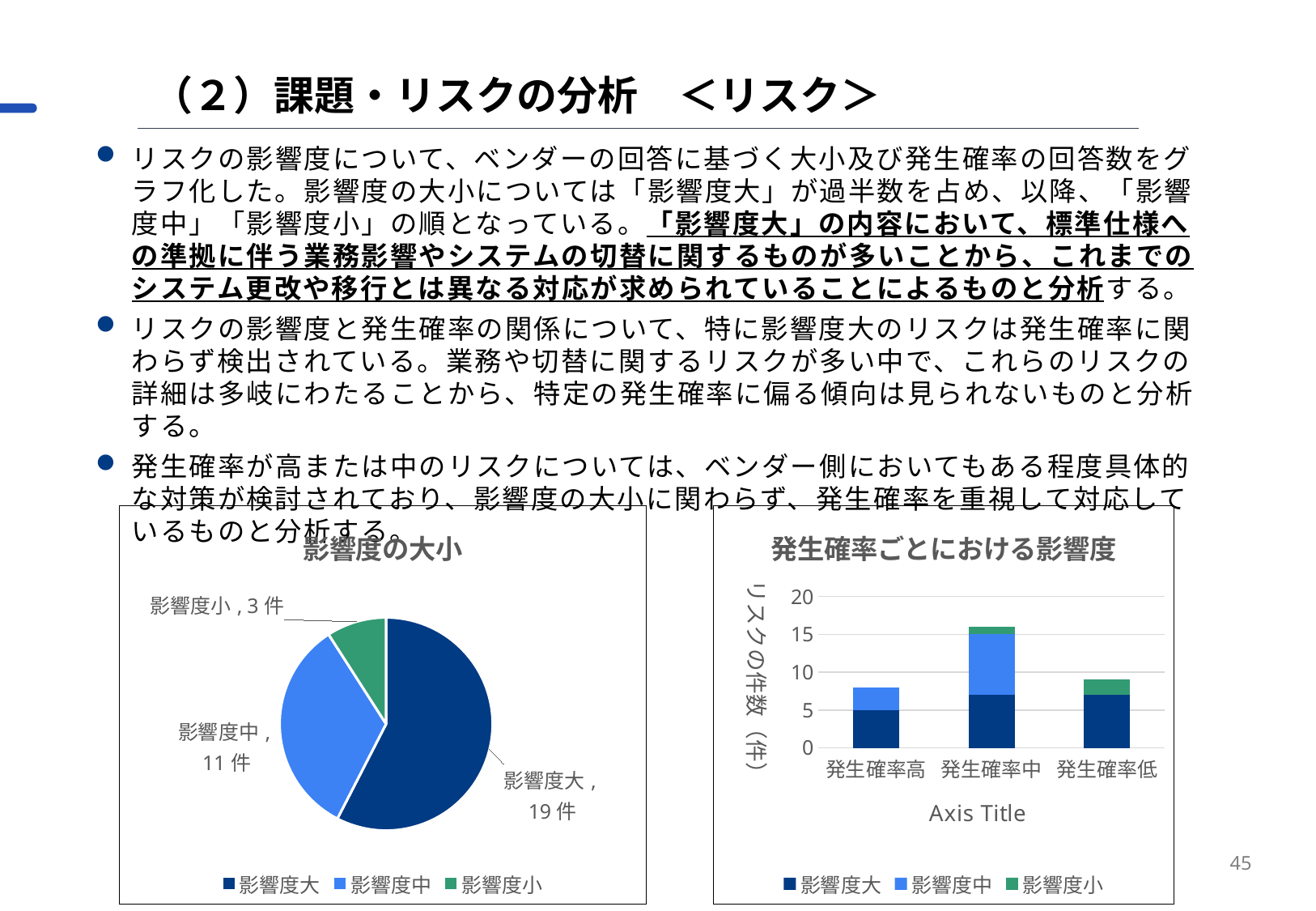
In the pie chart titled 影響度の大小, which category has the largest slice? 影響度大 In the pie chart titled 影響度の大小, how many categories are shown? 3 In the chart titled 発生確率ごとにおける影響度, is the total for 発生確率高 greater or less than 10? less What kind of chart is the chart on the left titled 影響度の大小? Pie chart In the pie chart titled 影響度の大小, how many cases are labelled 影響度中? 11 件 In the chart titled 発生確率ごとにおける影響度, which category has the tallest stacked bar? 発生確率中 In the pie chart titled 影響度の大小, how many cases are labelled 影響度小? 3 件 In the pie chart titled 影響度の大小, which category has the smallest slice? 影響度小 In the pie chart titled 影響度の大小, what is the difference between the 影響度大 count and the 影響度中 count? 8 件 In the pie chart titled 影響度の大小, how many cases are labelled 影響度大? 19 件 In the chart titled 発生確率ごとにおける影響度, how many series does the legend list? 3 What kind of chart is the chart on the right titled 発生確率ごとにおける影響度? Stacked bar chart